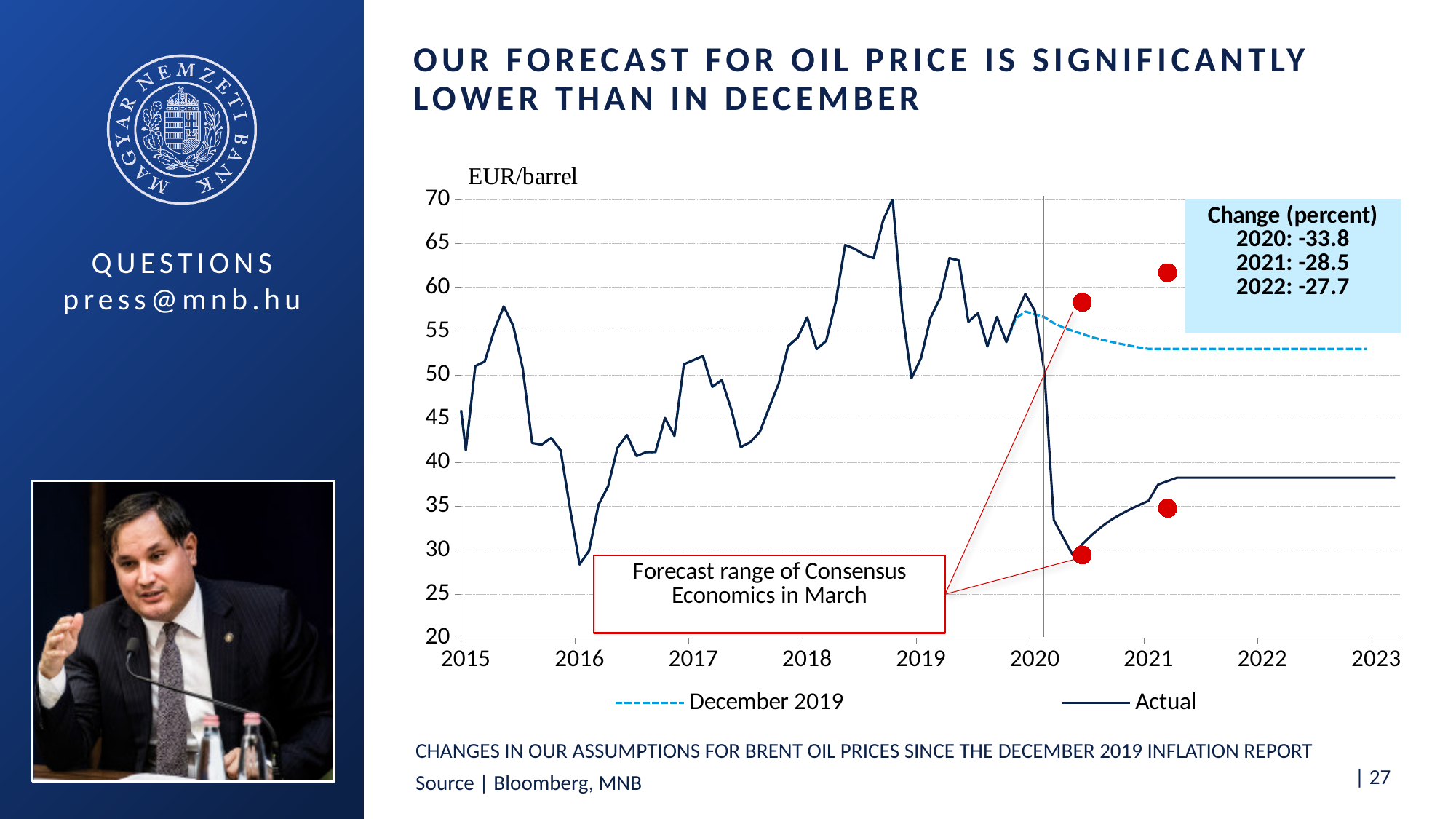
Is the lowest point of the Actual series in 2016 greater or less than 30? less Is the Actual series value at the end of 2022 greater or less than 40? less Does the Actual series rise or fall between the end of 2019 and early 2020? fall What kind of chart is shown on the slide? line chart According to the text box on the chart, what is the change in percent for 2021? -28.5 What are the two series named in the chart legend? December 2019 and Actual Is the December 2019 series value during 2022 greater or less than 50? greater According to the text box on the chart, what is the change in percent for 2022? -27.7 How many series does the chart legend list? 2 According to the text box on the chart, what is the change in percent for 2020? -33.8 In 2022, which series is higher: December 2019 or Actual? December 2019 What unit is shown on the vertical axis of the chart? EUR/barrel